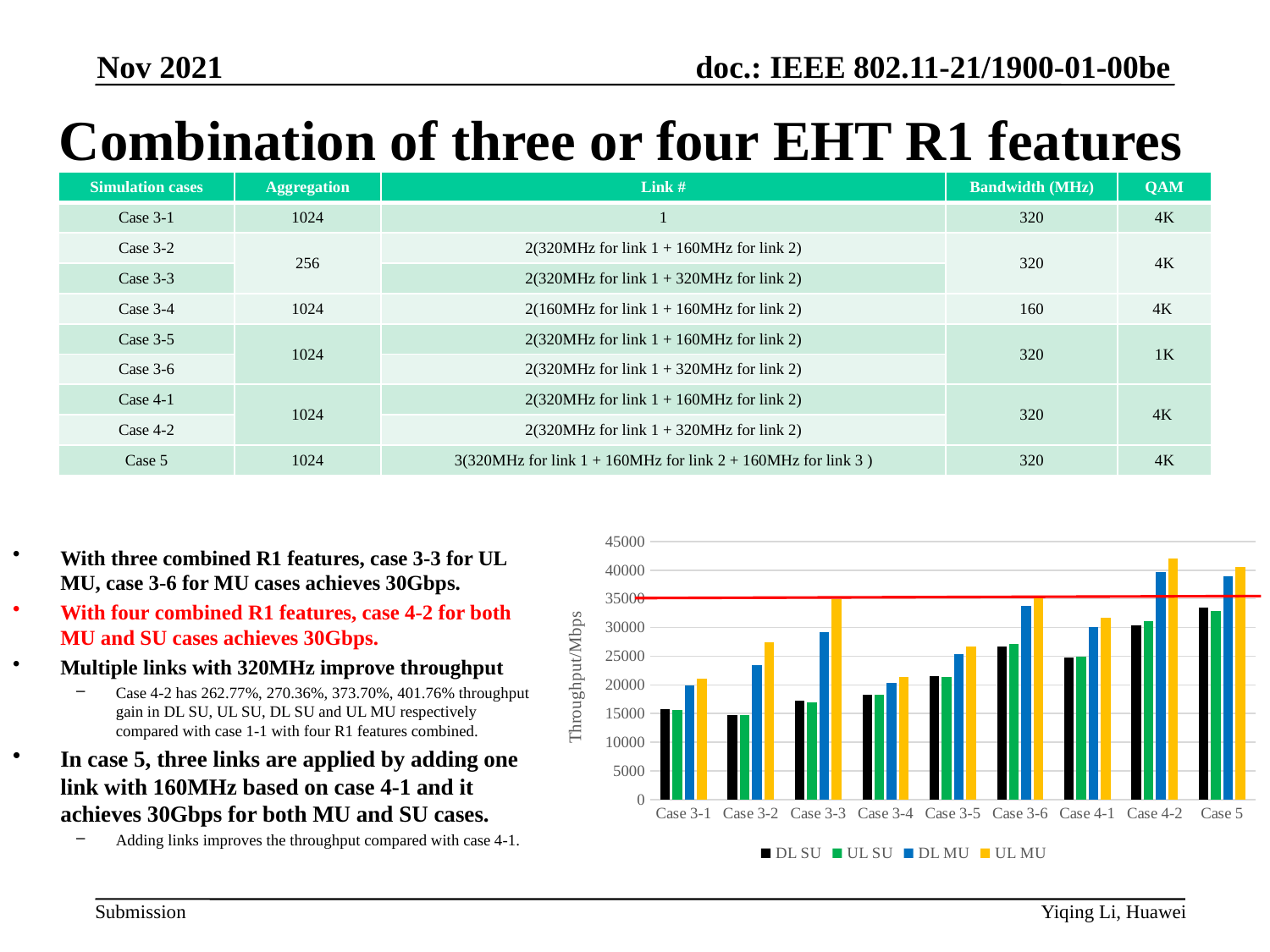
Is the DL SU value for Case 5 greater or less than 30000? greater Is the DL MU value for Case 4-2 greater or less than 35000? greater Is the UL MU value for Case 4-2 greater or less than 40000? greater How many simulation cases are shown along the x axis of the chart? 9 Which is larger, the DL MU value for Case 3-3 or the DL MU value for Case 3-2? Case 3-3 What is the label of the chart's vertical axis? Throughput/Mbps What kind of chart is shown on the slide? bar chart For which case is the UL MU bar the highest? Case 4-2 Which series in the chart is drawn in yellow? UL MU Which is larger, the UL MU value for Case 3-6 or the UL MU value for Case 4-1? Case 3-6 How many series does the chart legend list? 4